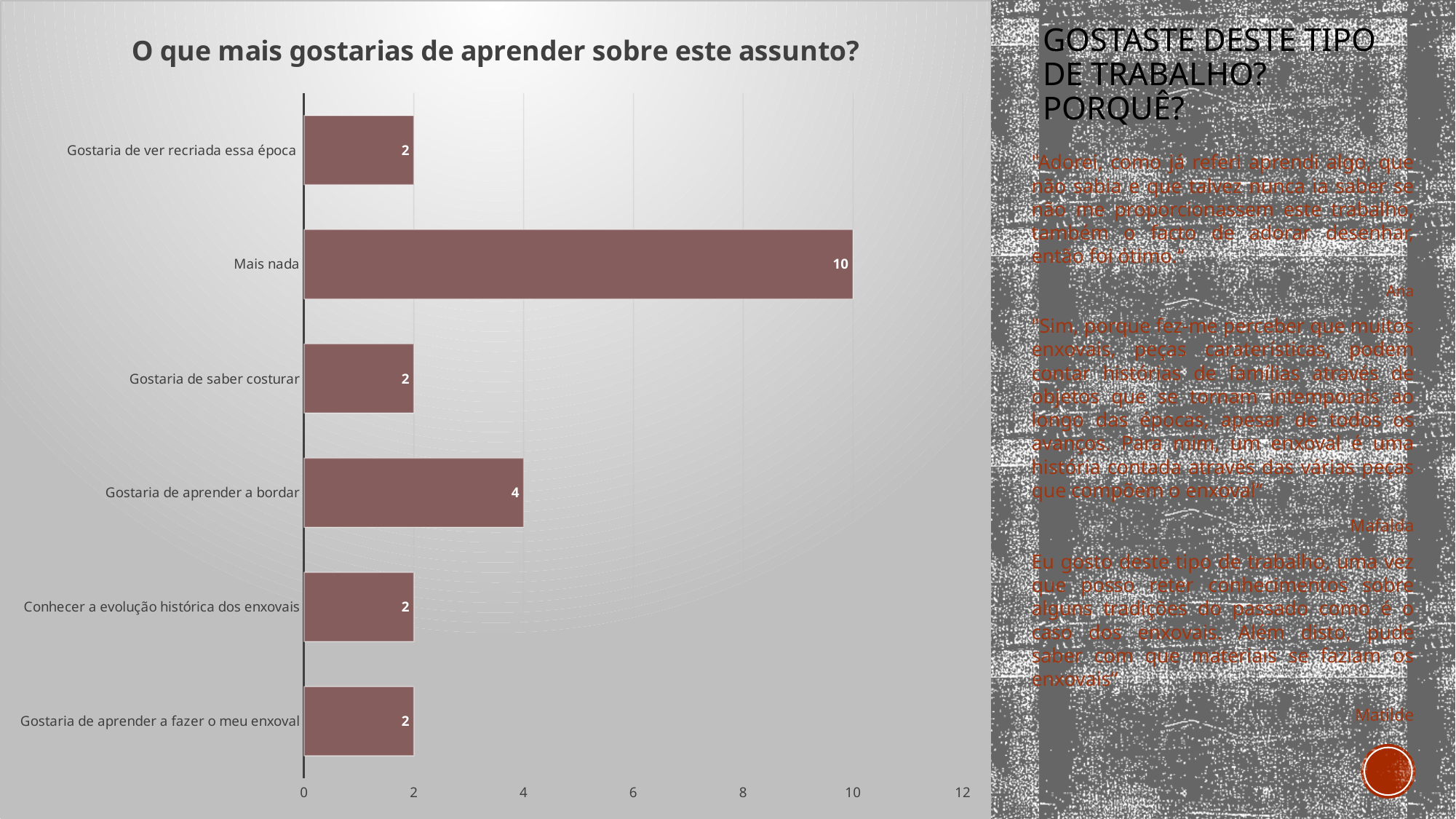
What is the value for "Gostaria de saber costurar"? 2 Which is larger: the value for "Gostaria de aprender a bordar" or the value for "Gostaria de ver recriada essa época"? Gostaria de aprender a bordar What is the title of the chart? O que mais gostarias de aprender sobre este assunto? What is the value for "Conhecer a evolução histórica dos enxovais"? 2 What kind of chart is shown on the slide? bar chart How many categories have a value of 2? 4 What is the value for "Gostaria de aprender a bordar"? 4 Is the value for "Mais nada" greater or less than 8? greater What is the difference between the values for "Mais nada" and "Gostaria de aprender a bordar"? 6 What is the value for "Mais nada"? 10 Which category has the highest value? Mais nada How many categories are shown in the chart? 6